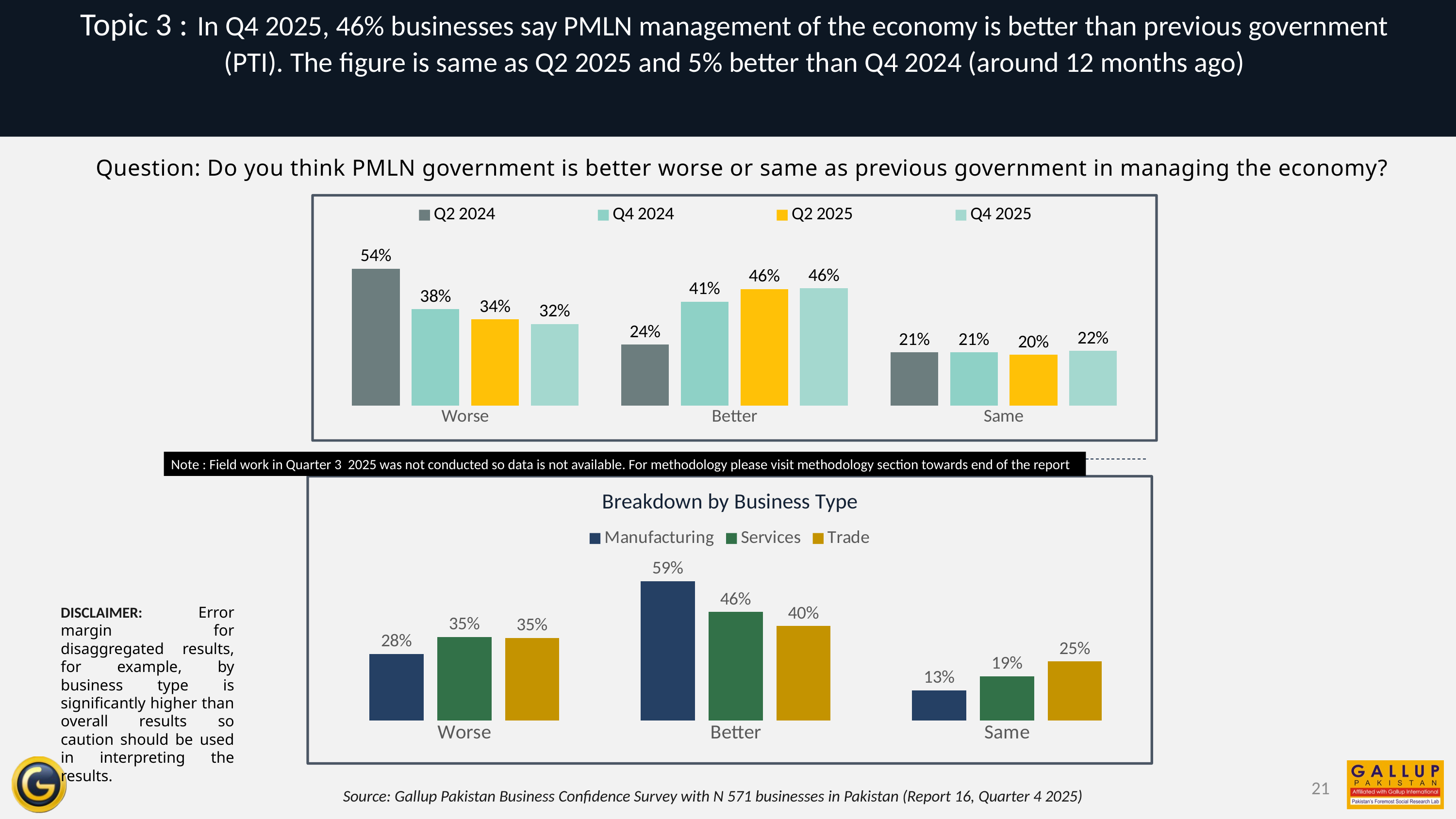
In the top chart, how many series does the legend list? 4 In the top chart, which quarter has the lowest value for 'Better'? Q2 2024 In the top chart, what is the difference between the Q2 2024 and Q4 2025 values for 'Worse'? 22% In the 'Breakdown by Business Type' chart, what is the Manufacturing value for 'Better'? 59% In the 'Breakdown by Business Type' chart, which business type has the highest value for 'Better'? Manufacturing In the top chart, what percentage of businesses said 'Worse' in Q2 2024? 54% In the top chart, do the 'Worse' values rise or fall from Q2 2024 to Q4 2025? fall In the 'Breakdown by Business Type' chart, what is the Trade value for 'Same'? 25% In the 'Breakdown by Business Type' chart, which is larger for 'Same': Services or Trade? Trade In the top chart, what is the Q2 2025 value for 'Same'? 20% In the top chart, what is the Q4 2025 value for 'Better'? 46% What kind of chart is the 'Breakdown by Business Type' chart? bar chart